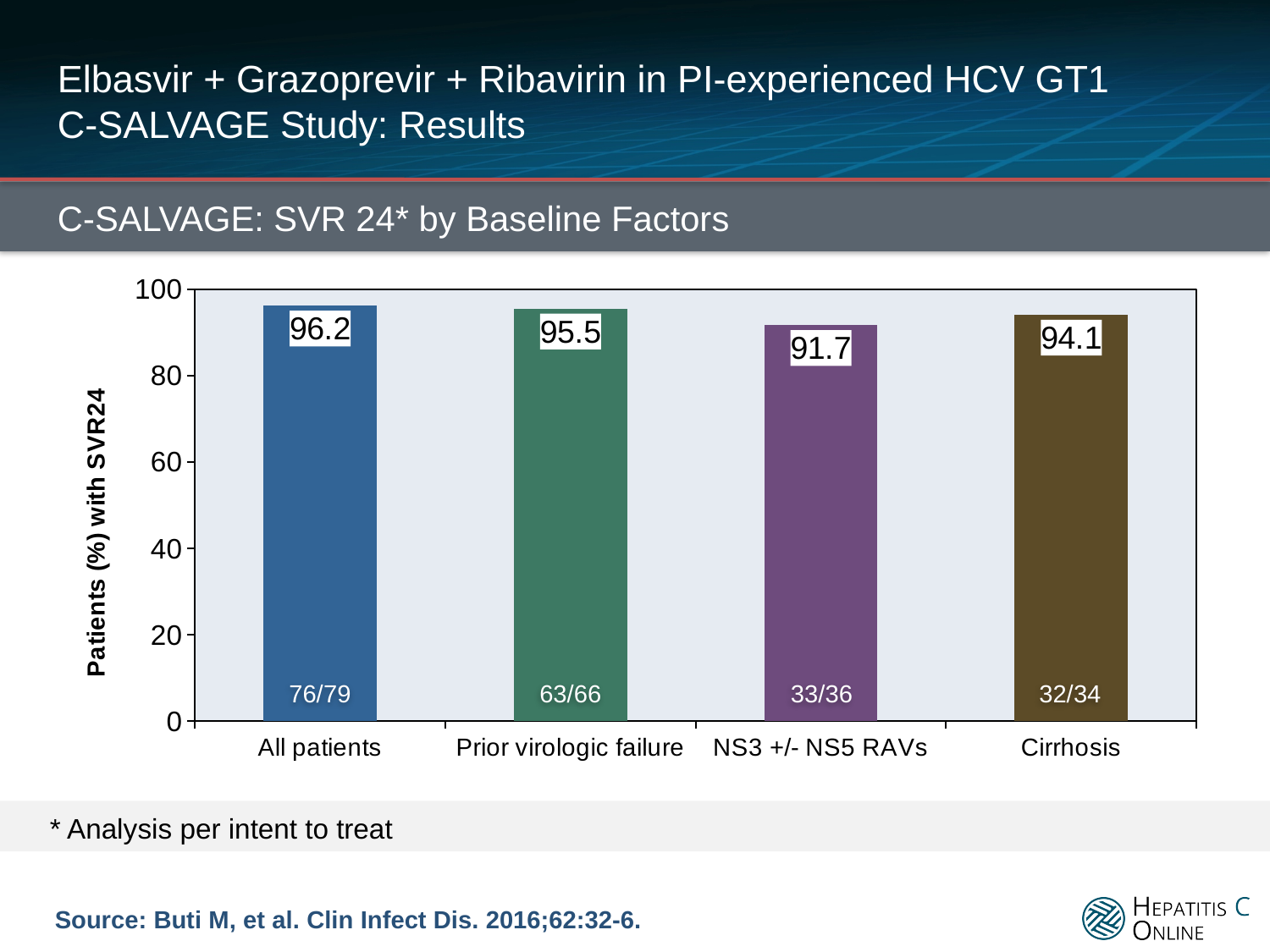
What kind of chart is shown on the slide? Bar chart Which category has the lowest SVR24 value? NS3 +/- NS5 RAVs How many categories are shown on the x axis? 4 What is the SVR24 value for NS3 +/- NS5 RAVs? 91.7 Which category has the highest SVR24 value? All patients What is the difference between the SVR24 values for All patients and NS3 +/- NS5 RAVs? 4.5 What fraction of patients is printed on the Cirrhosis bar? 32/34 What is the SVR24 value for Cirrhosis? 94.1 What is the SVR24 value for All patients? 96.2 What is the SVR24 value for Prior virologic failure? 95.5 What is the label of the y axis? Patients (%) with SVR24 Which has a higher SVR24 value, Prior virologic failure or Cirrhosis? Prior virologic failure